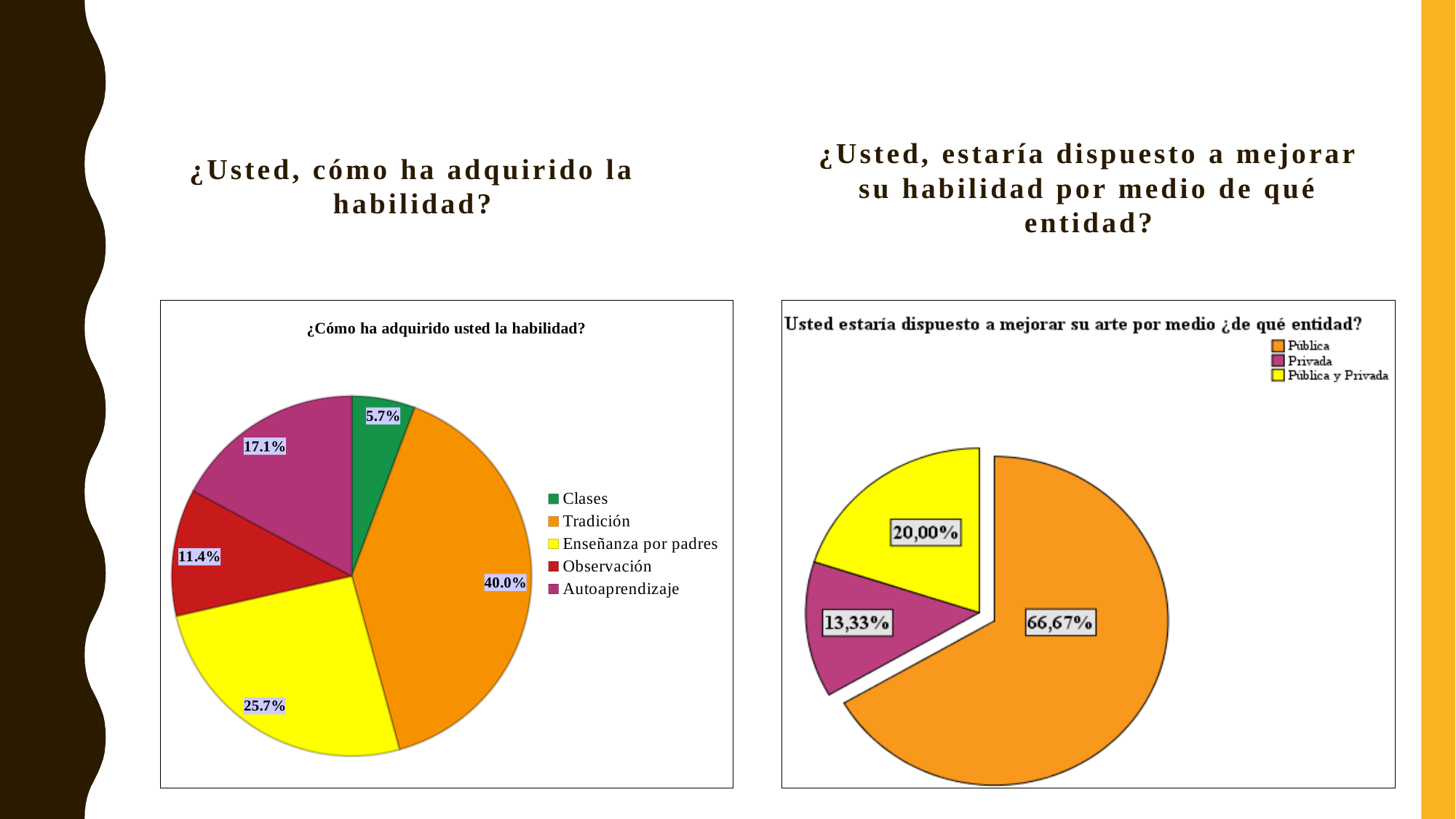
In the right chart 'Usted estaría dispuesto a mejorar su arte por medio ¿de qué entidad?', what share does Privada have? 13,33% In the left chart '¿Cómo ha adquirido usted la habilidad?', which category has the smallest slice? Clases In the right chart 'Usted estaría dispuesto a mejorar su arte por medio ¿de qué entidad?', what share does Pública have? 66,67% In the left chart '¿Cómo ha adquirido usted la habilidad?', what share does Tradición have? 40.0% In the left chart '¿Cómo ha adquirido usted la habilidad?', what is the difference between Autoaprendizaje and Observación? 5.7% In the right chart 'Usted estaría dispuesto a mejorar su arte por medio ¿de qué entidad?', which category has the largest slice? Pública In the right chart 'Usted estaría dispuesto a mejorar su arte por medio ¿de qué entidad?', which is larger, Privada or Pública y Privada? Pública y Privada In the left chart '¿Cómo ha adquirido usted la habilidad?', what share does Enseñanza por padres have? 25.7% In the left chart '¿Cómo ha adquirido usted la habilidad?', what share does Clases have? 5.7% In the left chart '¿Cómo ha adquirido usted la habilidad?', which category has the largest slice? Tradición What type of chart is the right chart 'Usted estaría dispuesto a mejorar su arte por medio ¿de qué entidad?'? Pie chart In the left chart '¿Cómo ha adquirido usted la habilidad?', how many categories does the legend list? 5